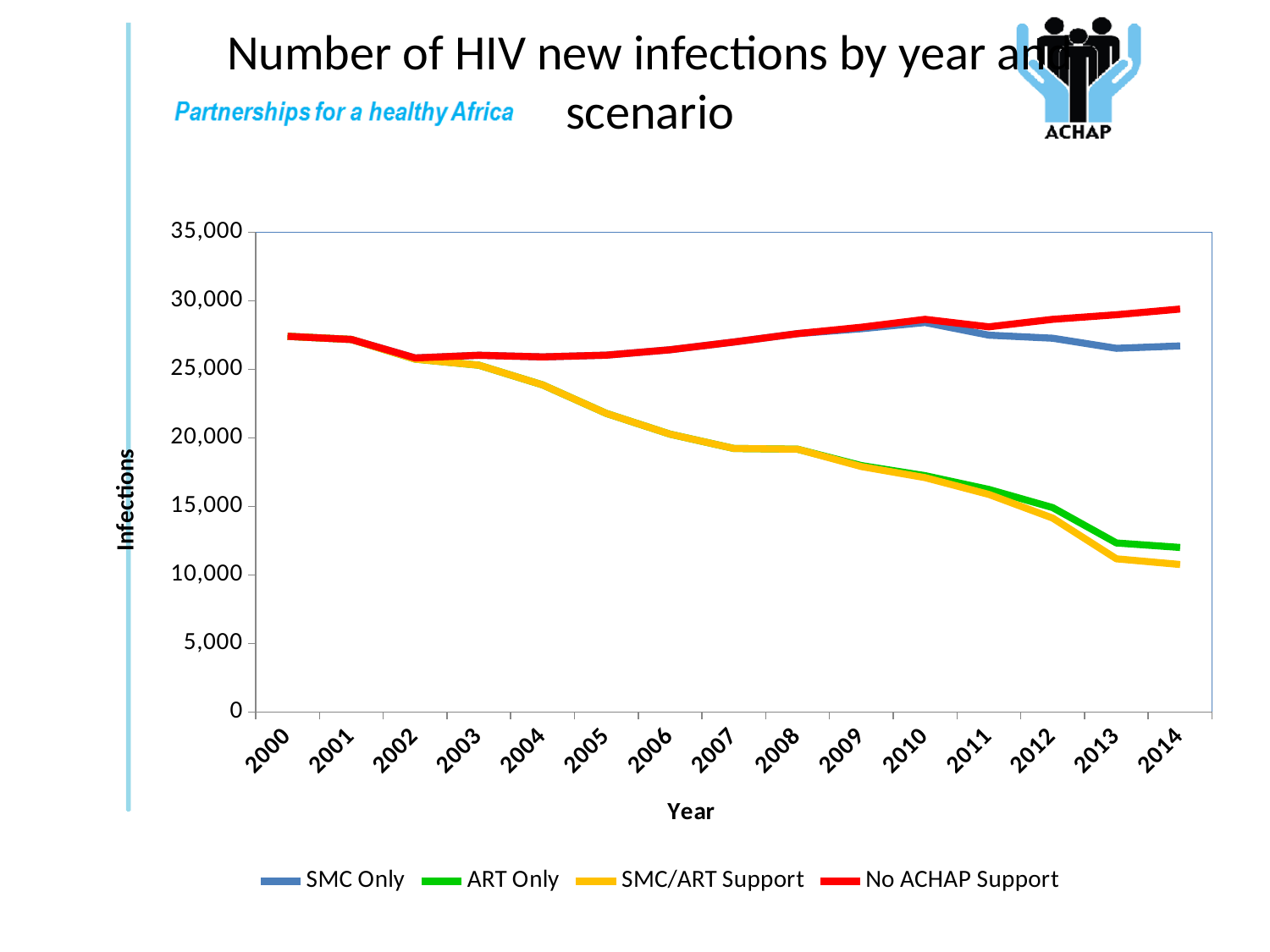
Which series has the lowest value in 2014? SMC/ART Support Is the value for SMC/ART Support in 2014 greater or less than 15,000? less What is the label on the y axis? Infections What kind of chart is shown on the slide? line chart How many series does the legend list? 4 Is the value for No ACHAP Support in 2014 greater or less than 25,000? greater Does the No ACHAP Support series rise or fall from 2005 to 2014? rise Does the SMC/ART Support series rise or fall from 2000 to 2014? fall How many years are plotted along the x axis? 15 Is the value for ART Only in 2010 greater or less than 20,000? less In 2014, which is larger: ART Only or SMC/ART Support? ART Only Which series has the highest value in 2014? No ACHAP Support